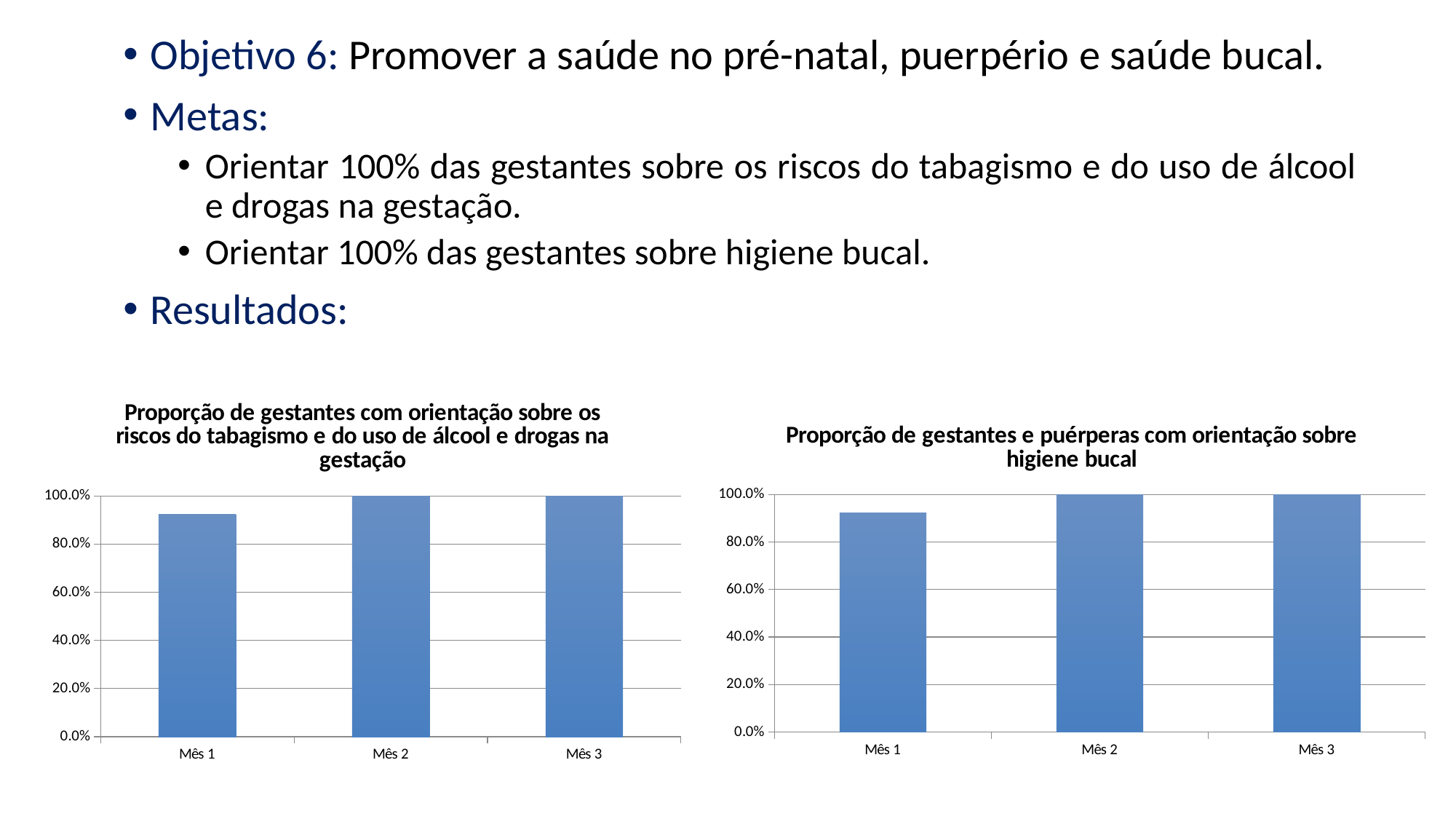
In the left chart, is the value for Mês 1 greater or less than 80.0%? greater In the right chart, which month has the lowest value? Mês 1 In the left chart, which is larger, the value for Mês 1 or the value for Mês 2? Mês 2 In the right chart (Proporção de gestantes e puérperas com orientação sobre higiene bucal), what is the value for Mês 3? 100.0% In the left chart (Proporção de gestantes com orientação sobre os riscos do tabagismo e do uso de álcool e drogas na gestação), what is the value for Mês 2? 100.0% What is the title of the right chart? Proporção de gestantes e puérperas com orientação sobre higiene bucal What kind of chart is the right chart? bar chart How many categories are shown on the x axis of the left chart? 3 In the right chart, which is larger, the value for Mês 3 or the value for Mês 1? Mês 3 In the right chart, is the value for Mês 1 greater or less than 100.0%? less In the left chart, do the values rise or fall from Mês 1 to Mês 3? rise In the left chart, which month has the lowest value? Mês 1